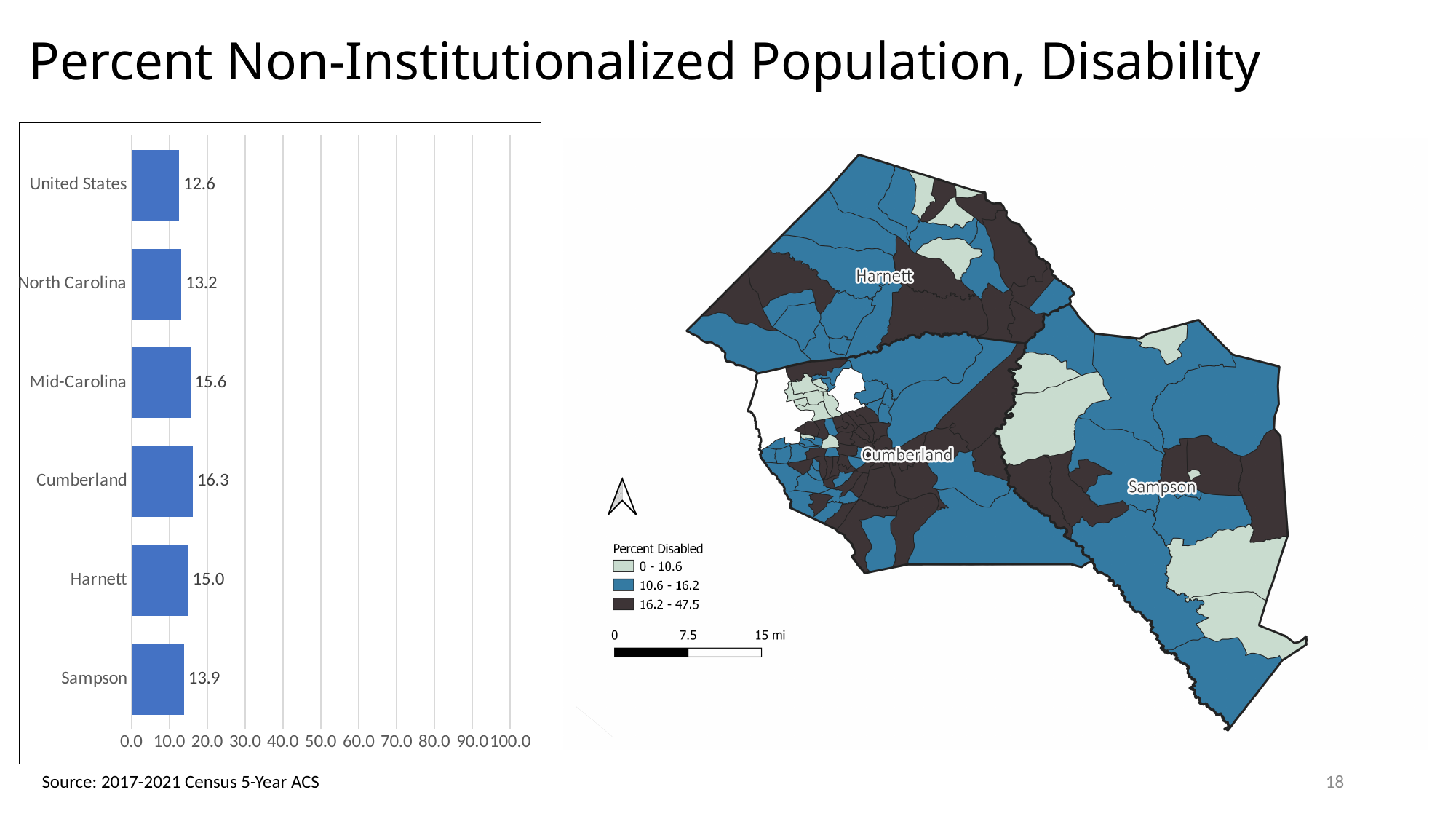
What kind of chart is shown on the left of the slide? Bar chart Which is larger in the bar chart, Mid-Carolina or Harnett? Mid-Carolina What is the value for Harnett in the bar chart? 15.0 Is the value for Sampson in the bar chart greater or less than 20.0? less How many ranges does the map legend for Percent Disabled list? 3 What is the difference between the values for Cumberland and North Carolina in the bar chart? 3.1 What is the value for the United States in the bar chart? 12.6 Which category has the lowest value in the bar chart? United States Which category has the highest value in the bar chart? Cumberland How many categories are shown in the bar chart? 6 What is the value for Cumberland in the bar chart? 16.3 What is the value for Sampson in the bar chart? 13.9